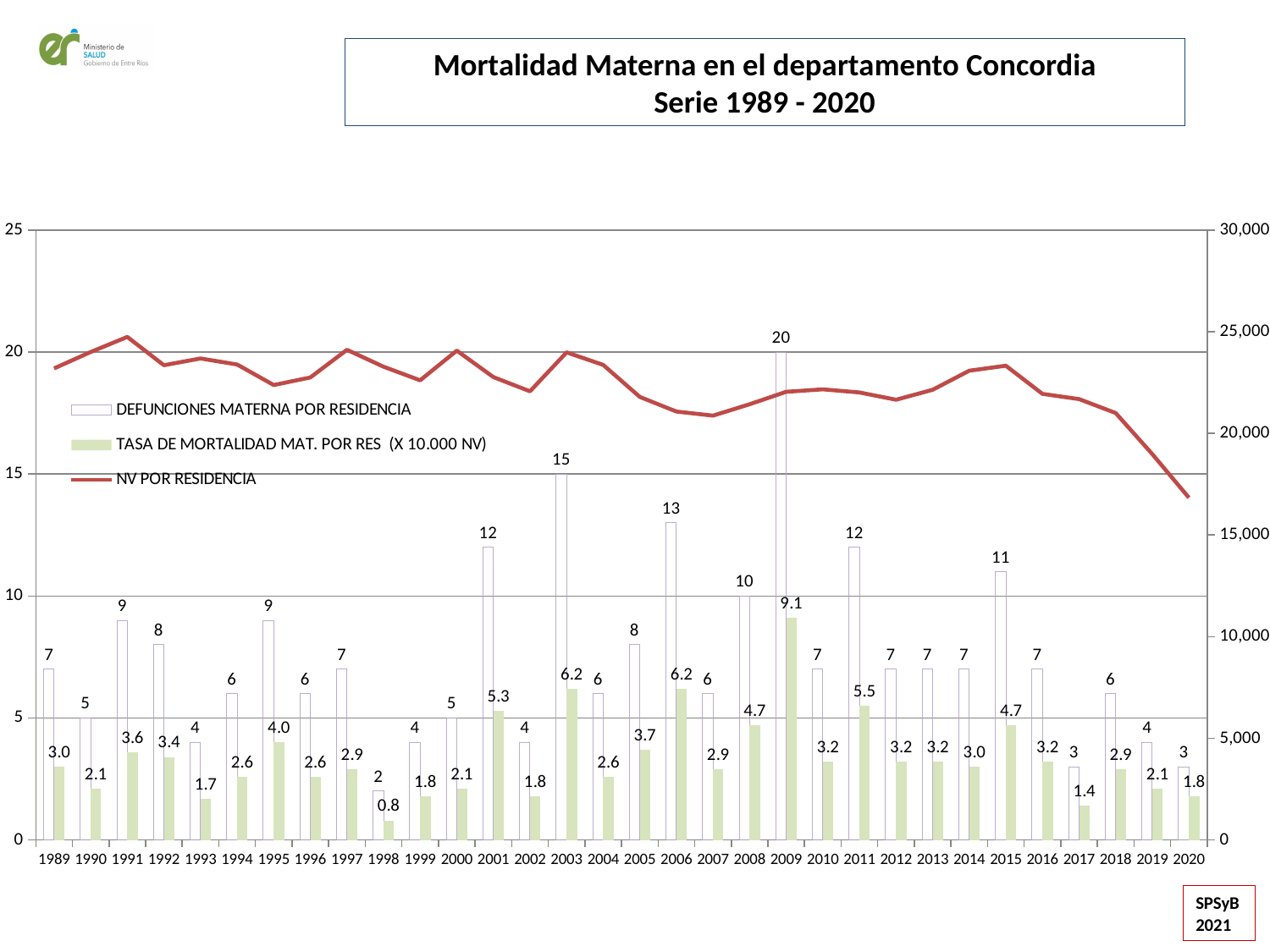
How many years are shown on the x axis? 32 Is the NV POR RESIDENCIA value for 1991 greater or less than 20,000? greater What is the TASA DE MORTALIDAD MAT. POR RES value for 2003? 6.2 Which year has the highest value of DEFUNCIONES MATERNA POR RESIDENCIA? 2009 Which year has the larger DEFUNCIONES MATERNA POR RESIDENCIA value, 2006 or 2015? 2006 What is the value of DEFUNCIONES MATERNA POR RESIDENCIA for 2009? 20 Does the NV POR RESIDENCIA line rise or fall from 2015 to 2020? fall What is the TASA DE MORTALIDAD MAT. POR RES value for 2017? 1.4 How many series does the legend list? 3 Which year has the lowest TASA DE MORTALIDAD MAT. POR RES value? 1998 Is the NV POR RESIDENCIA value for 2020 greater or less than 20,000? less What is the difference between the DEFUNCIONES MATERNA POR RESIDENCIA values for 2003 and 2001? 3